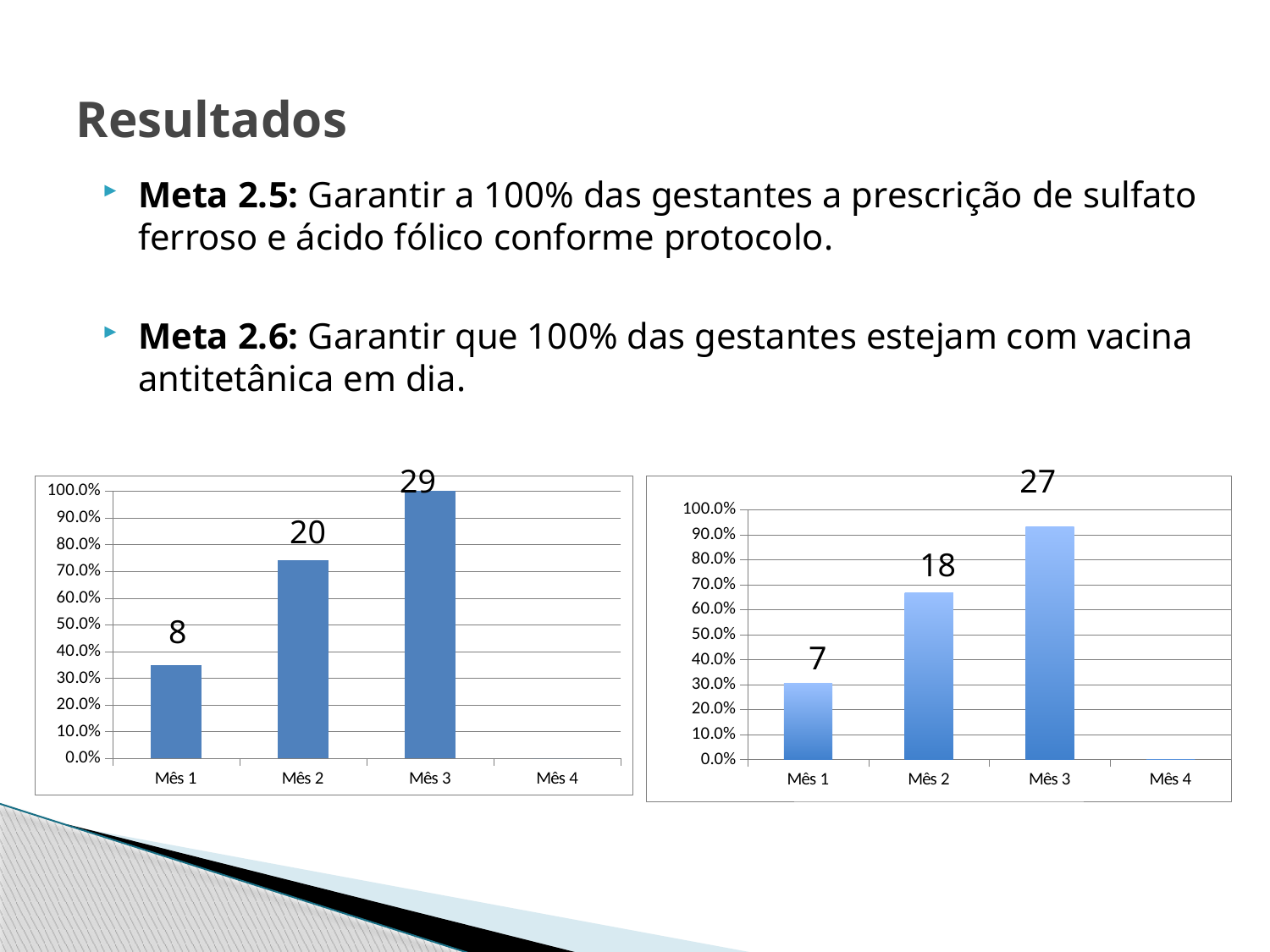
What type of chart is the right chart? Bar chart In the right chart, what data label is shown above the bar for Mês 1? 7 In the right chart, is the bar for Mês 3 taller than the bar for Mês 2? Yes How many month categories are shown on the x axis of the left chart? 4 In the left chart, is the value for Mês 1 greater or less than 40.0%? less In the left chart, which month has the tallest bar? Mês 3 In the right chart, what data label is shown above the bar for Mês 3? 27 In the left chart, what is the difference between the data labels for Mês 3 and Mês 1? 21 In the right chart, is the value for Mês 3 greater or less than 90.0%? greater In the left chart, what data label is shown above the bar for Mês 2? 20 In the left chart, what data label is shown above the bar for Mês 1? 8 In the right chart, which month with a visible bar has the shortest bar? Mês 1